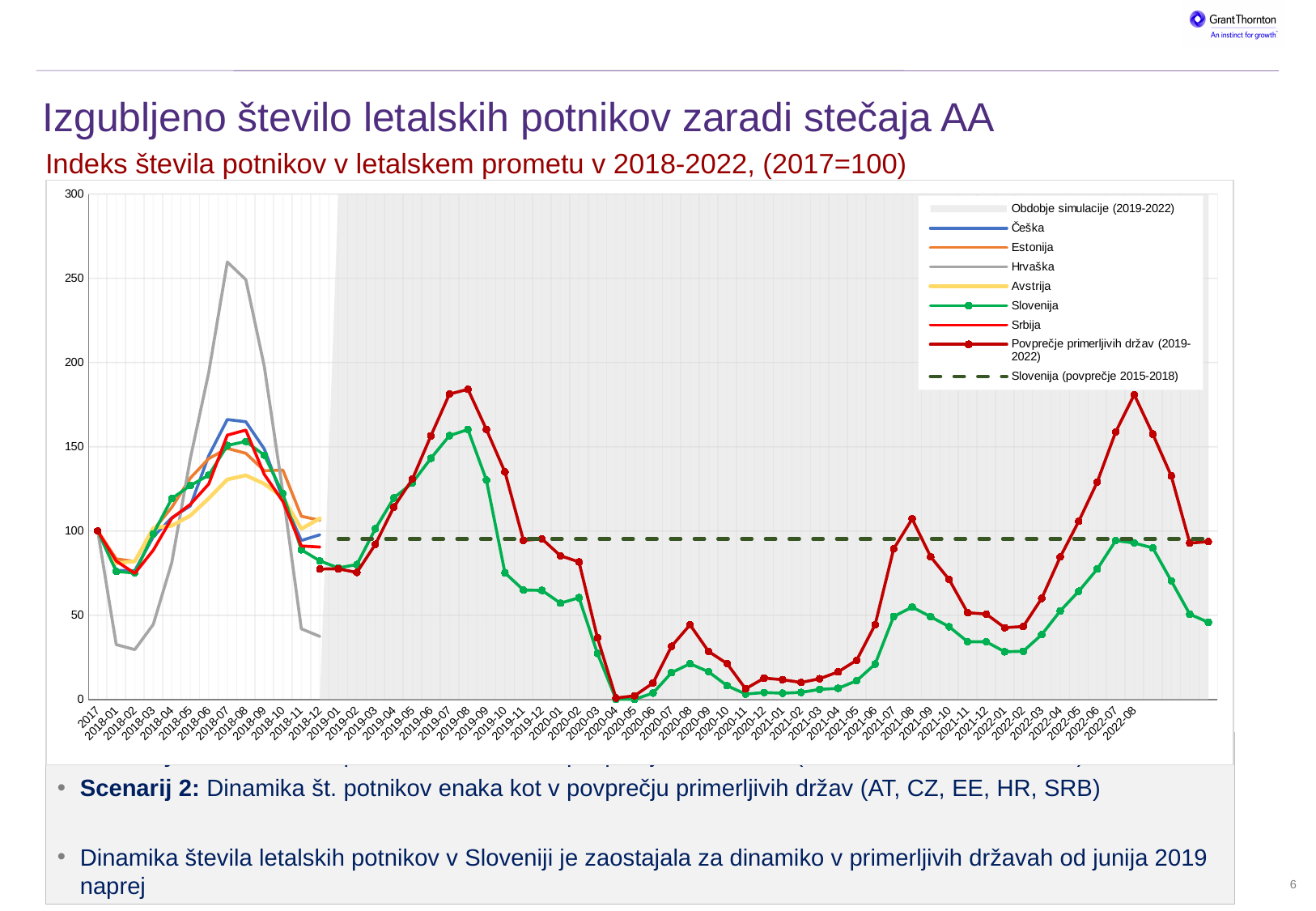
Is the value for Hrvaška in 2018-01 greater or less than 50? less Is the value for Slovenija in 2020-04 greater or less than 50? less Is the value for Povprečje primerljivih držav (2019-2022) in 2022-07 greater or less than 150? greater Does the Slovenija series rise or fall between 2022-07 and 2022-08? fall How many entries does the chart legend list? 9 What does the grey shaded area of the chart represent, according to the legend? Obdobje simulacije (2019-2022) Which legend entry is drawn as a dashed line? Slovenija (povprečje 2015-2018) In 2019-08, which is higher: Slovenija or Povprečje primerljivih držav (2019-2022)? Povprečje primerljivih držav (2019-2022) Which series reaches the highest value in 2018-07? Hrvaška What kind of chart is shown on the slide? line chart